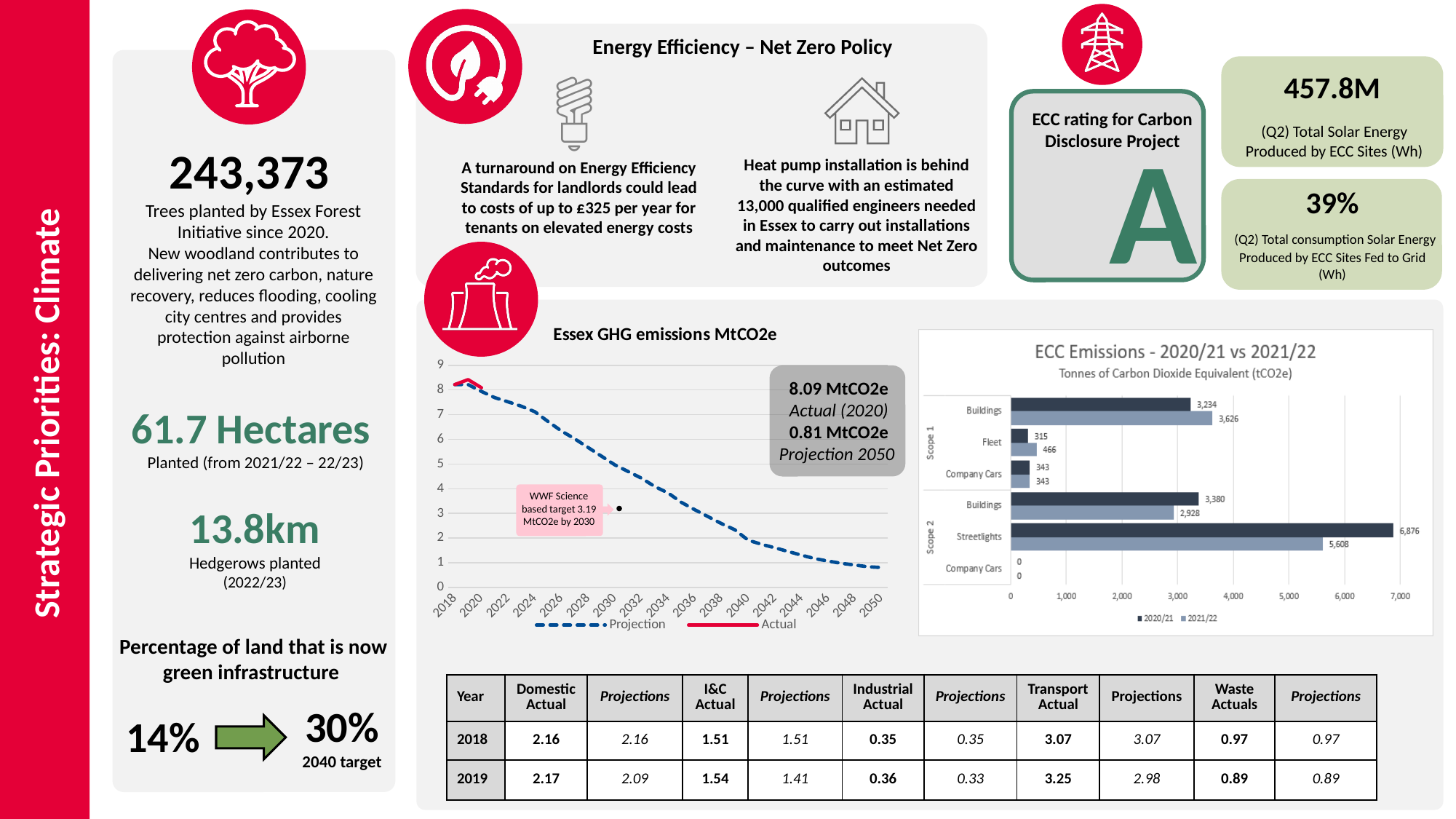
In the Essex GHG emissions MtCO2e chart, what is the projected value for 2050? 0.81 MtCO2e What kind of chart is the Essex GHG emissions MtCO2e chart? Line chart In the Essex GHG emissions MtCO2e chart, is the projected value for 2040 greater or less than 3? less What kind of chart is the ECC Emissions - 2020/21 vs 2021/22 chart? Bar chart In the Essex GHG emissions MtCO2e chart, does the projection rise or fall from 2020 to 2050? Fall In the ECC Emissions - 2020/21 vs 2021/22 chart, which category and year has the highest value? Scope 2 Streetlights, 2020/21 In the ECC Emissions - 2020/21 vs 2021/22 chart, what is the difference between the 2020/21 and 2021/22 values for Scope 2 Streetlights? 1,268 In the ECC Emissions - 2020/21 vs 2021/22 chart, what is the 2021/22 value for Scope 1 Buildings? 3,626 In the ECC Emissions - 2020/21 vs 2021/22 chart, which year has the larger value for Scope 1 Fleet? 2021/22 How many series does the legend of the ECC Emissions - 2020/21 vs 2021/22 chart list? 2 What are the two legend entries of the Essex GHG emissions MtCO2e chart? Projection and Actual In the ECC Emissions - 2020/21 vs 2021/22 chart, what is the 2020/21 value for Scope 2 Streetlights? 6,876